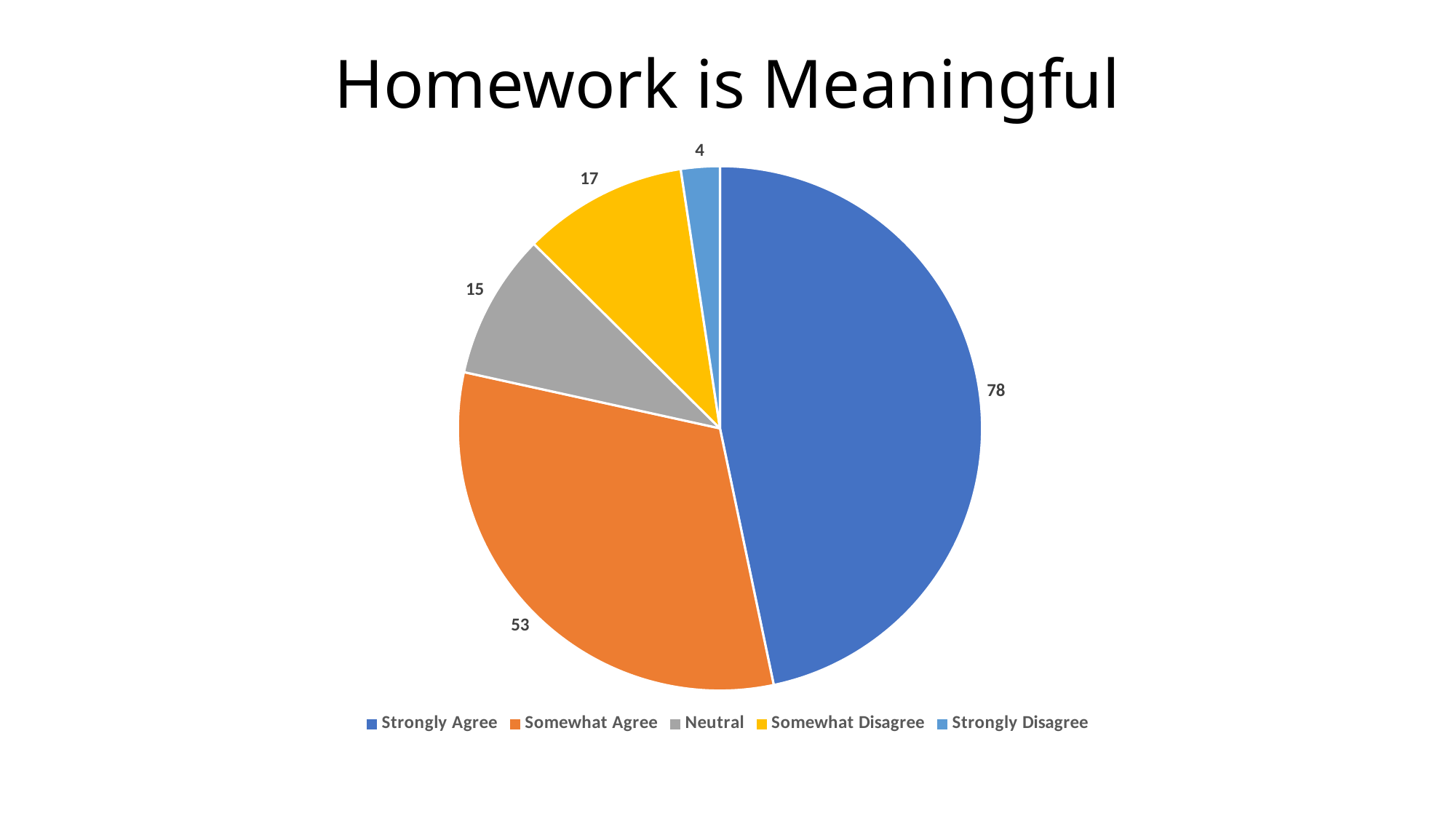
Which is larger, the value for Neutral or the value for Somewhat Disagree? Somewhat Disagree What is the value for Strongly Agree? 78 Which category has the smallest slice? Strongly Disagree What is the difference between the values for Strongly Agree and Somewhat Agree? 25 What is the value for Somewhat Disagree? 17 Which category has the largest slice? Strongly Agree How many categories does the legend list? 5 What is the value for Strongly Disagree? 4 What is the value for Somewhat Agree? 53 What type of chart is shown on the slide? Pie chart What is the title of the chart? Homework is Meaningful What is the value for Neutral? 15